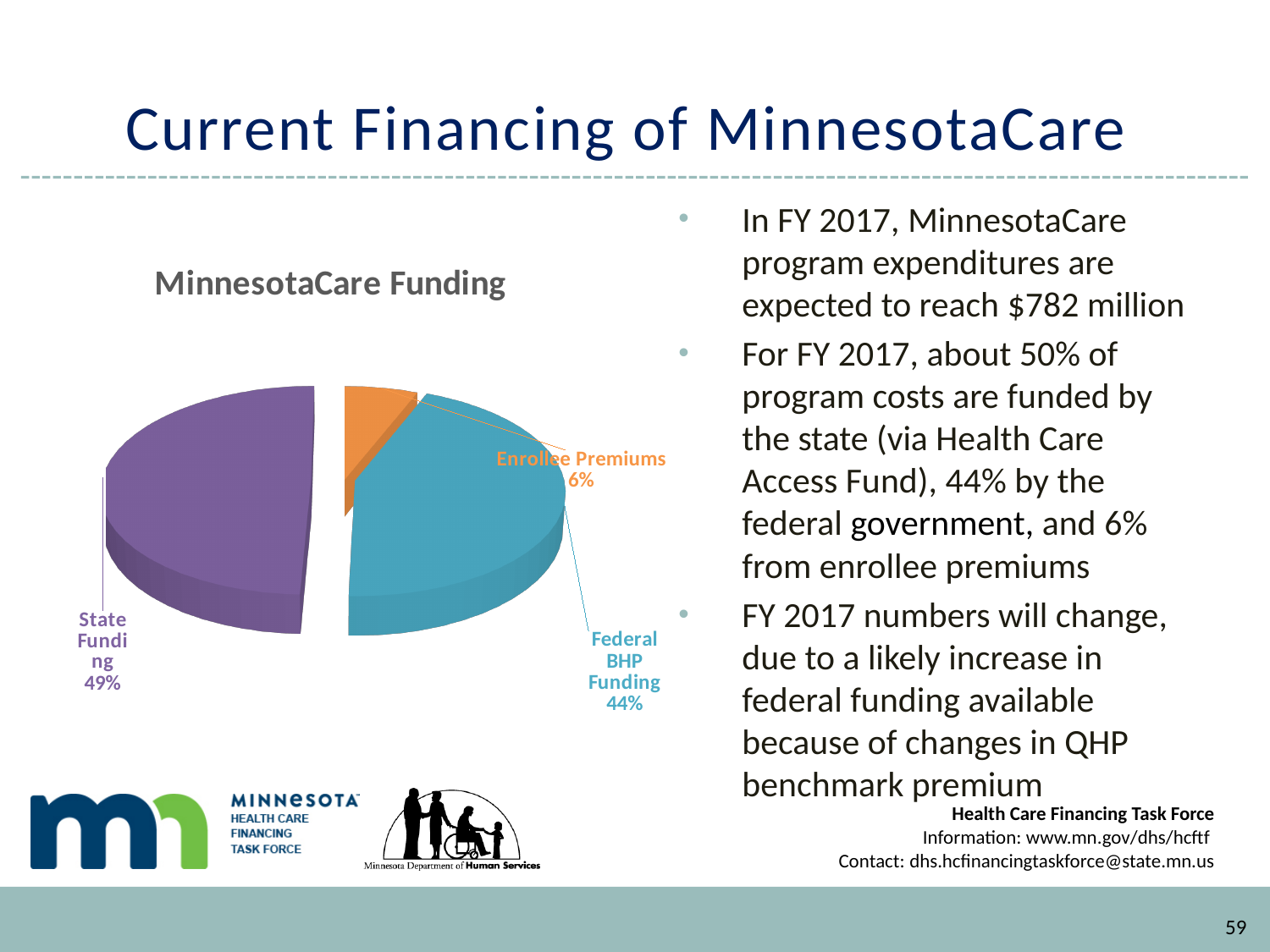
What is the title of the chart on the slide? MinnesotaCare Funding What is the difference in percentage points between Federal BHP Funding and Enrollee Premiums? 38 percentage points Which funding source has the largest share in the MinnesotaCare Funding chart? State Funding What is the difference in percentage points between State Funding and Federal BHP Funding? 5 percentage points What share of MinnesotaCare Funding comes from Federal BHP Funding? 44% What type of chart is shown on the slide? Pie chart What share of MinnesotaCare Funding comes from Enrollee Premiums? 6% What colour is the Enrollee Premiums slice in the pie chart? Orange Which is larger, the share for Federal BHP Funding or the share for Enrollee Premiums? Federal BHP Funding What share of MinnesotaCare Funding comes from State Funding? 49% Which funding source has the smallest share in the MinnesotaCare Funding chart? Enrollee Premiums How many slices does the MinnesotaCare Funding pie chart have? 3